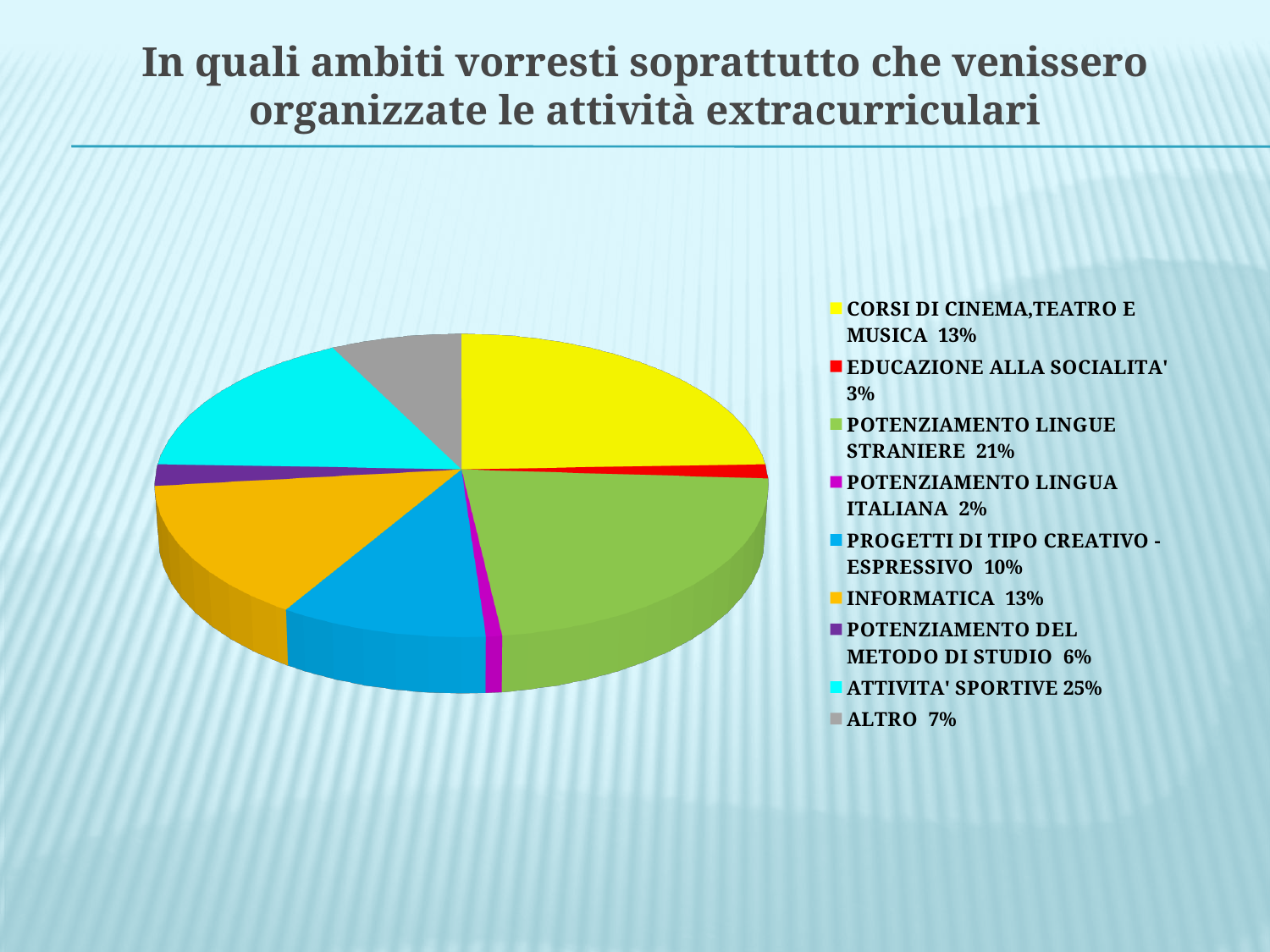
How many categories (slices) does the pie chart have? 9 What is the difference in percentage points between ATTIVITA' SPORTIVE and POTENZIAMENTO LINGUE STRANIERE? 4 What percentage is shown for INFORMATICA? 13% What percentage is shown for POTENZIAMENTO DEL METODO DI STUDIO? 6% What percentage is shown for ATTIVITA' SPORTIVE? 25% What percentage is shown for POTENZIAMENTO LINGUE STRANIERE? 21% What kind of chart is shown on the slide? Pie chart Which category has the smallest share of the pie? POTENZIAMENTO LINGUA ITALIANA What colour is the slice for ATTIVITA' SPORTIVE? Cyan What share of the pie does EDUCAZIONE ALLA SOCIALITA' represent? 3% Which is larger, the share for PROGETTI DI TIPO CREATIVO - ESPRESSIVO or the share for ALTRO? PROGETTI DI TIPO CREATIVO - ESPRESSIVO